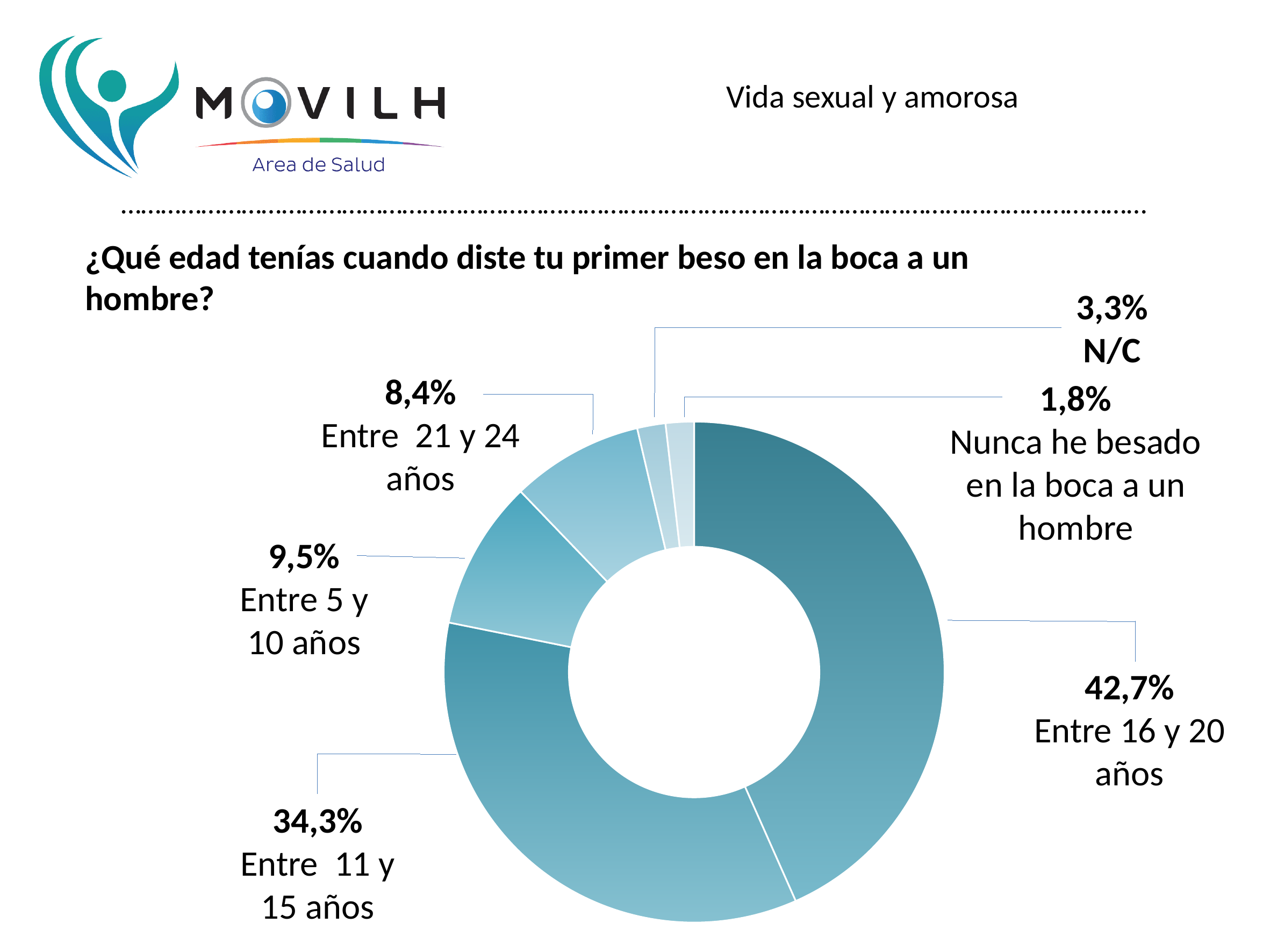
Which category has the largest share of the chart? Entre 16 y 20 años What is the value shown for 'Entre 11 y 15 años'? 34,3% What is the difference in percentage points between 'Entre 16 y 20 años' and 'Entre 11 y 15 años'? 8,4 What question does the chart answer, according to the title above it? ¿Qué edad tenías cuando diste tu primer beso en la boca a un hombre? How many categories are shown in the chart? 6 What percentage is shown for 'Nunca he besado en la boca a un hombre'? 1,8% What percentage is shown for N/C? 3,3% Which category has the smallest share of the chart? Nunca he besado en la boca a un hombre What type of chart is shown on the slide? Doughnut chart What percentage of respondents gave their first kiss to a man between 16 and 20 years old (Entre 16 y 20 años)? 42,7% What percentage is shown for 'Entre 5 y 10 años'? 9,5% Which is larger: the share for 'Entre 5 y 10 años' or for 'Entre 21 y 24 años'? Entre 5 y 10 años